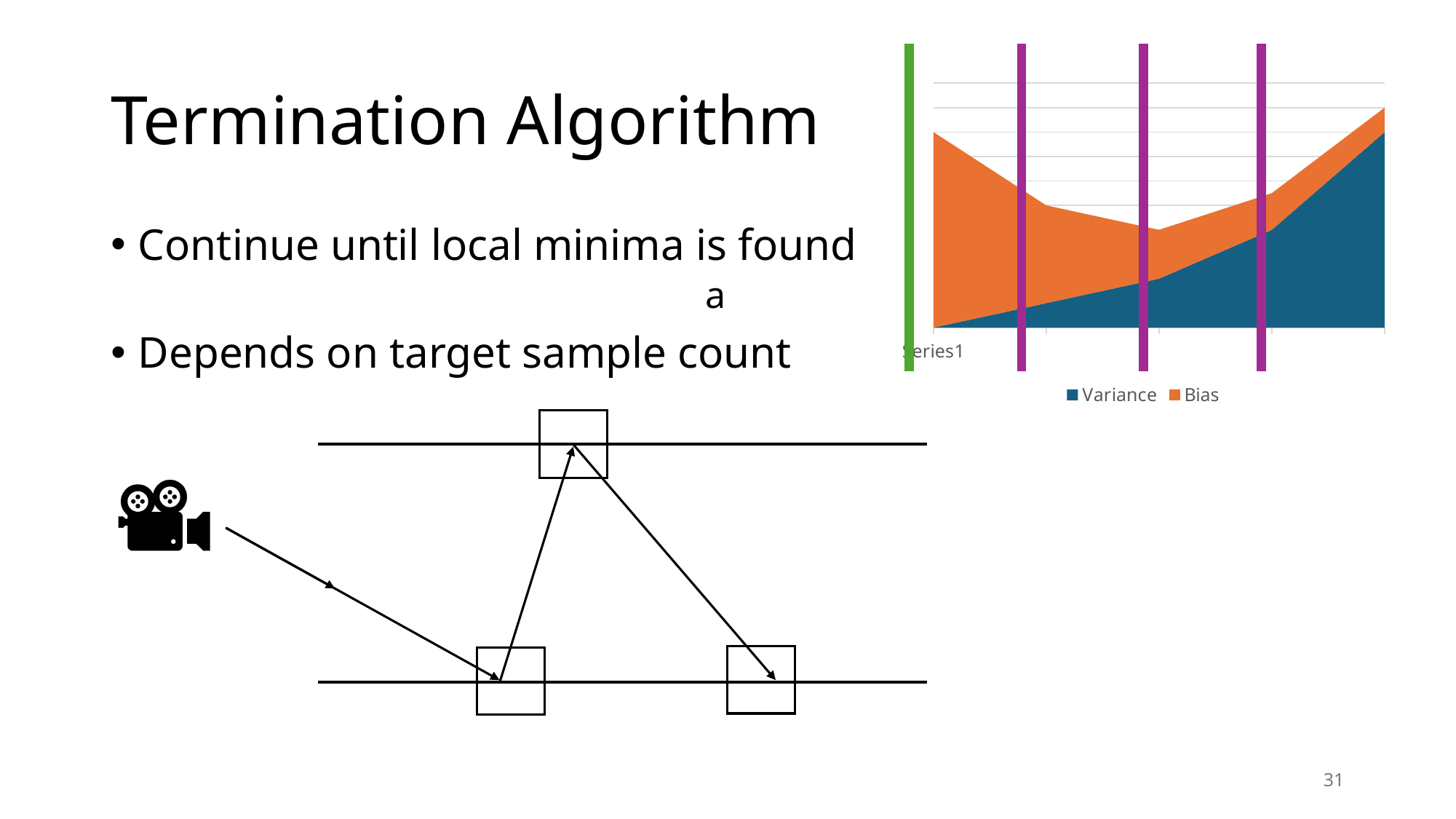
Which colour represents the Variance series in the chart? blue What are the two series named in the chart's legend? Variance and Bias How many series does the chart's legend list? 2 How many data points does each series in the chart have? 5 Does the Variance series rise or fall from left to right along the x axis? rise What kind of chart is shown on the slide? stacked area chart